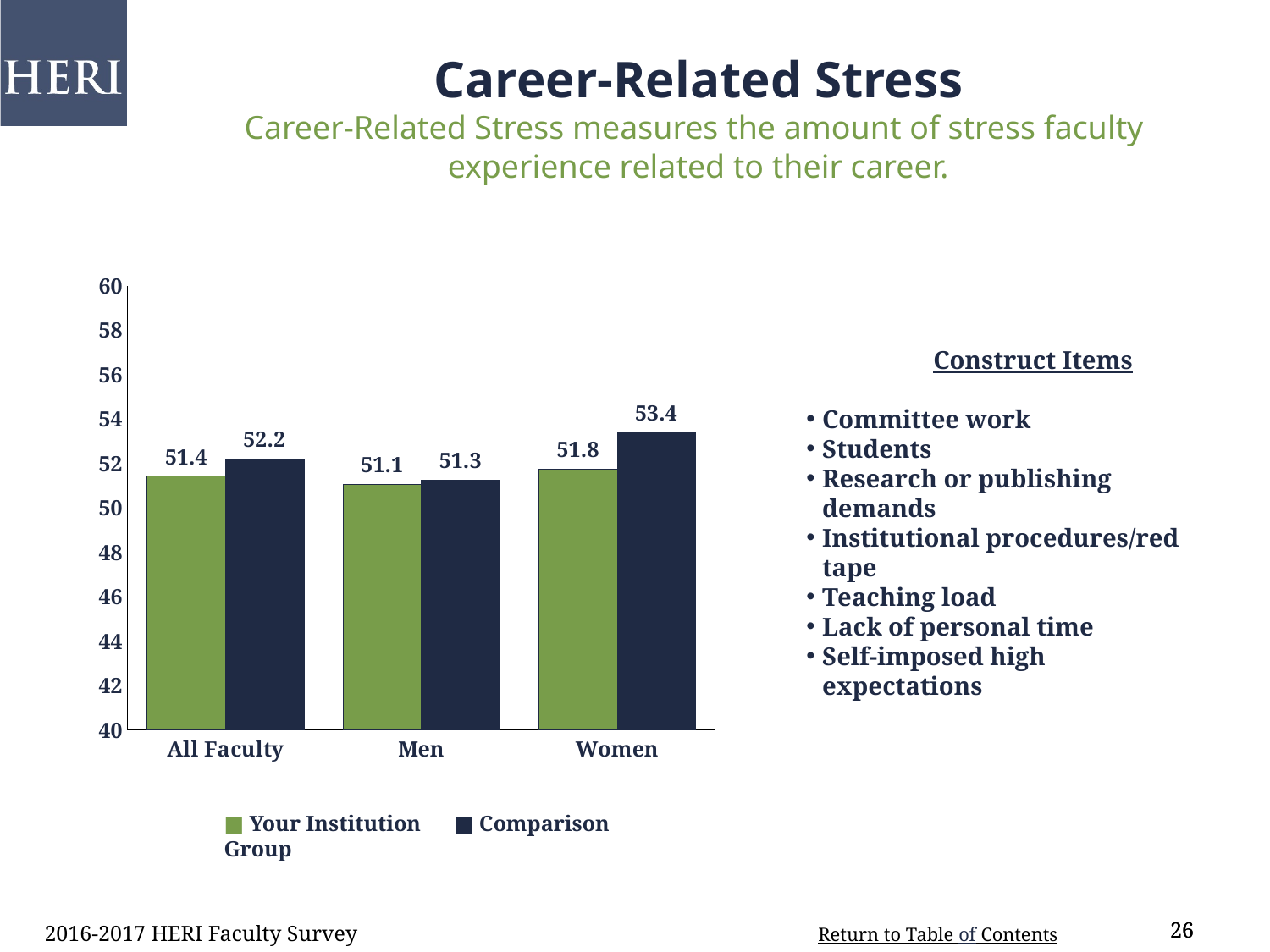
What is the difference between the Comparison Group and Your Institution values for Women? 1.6 Which category has the highest Comparison Group value? Women How many series does the legend list? 2 For All Faculty, which is larger: Your Institution or Comparison Group? Comparison Group What is the Comparison Group value for All Faculty? 52.2 What is the Comparison Group value for Men? 51.3 Which category has the lowest Your Institution value? Men What kind of chart is shown on the slide? bar chart What is the Your Institution value for Women? 51.8 What is the difference between the Your Institution values for Women and Men? 0.7 Is the Comparison Group value for Women greater or less than 52? greater How many categories are shown on the x axis? 3